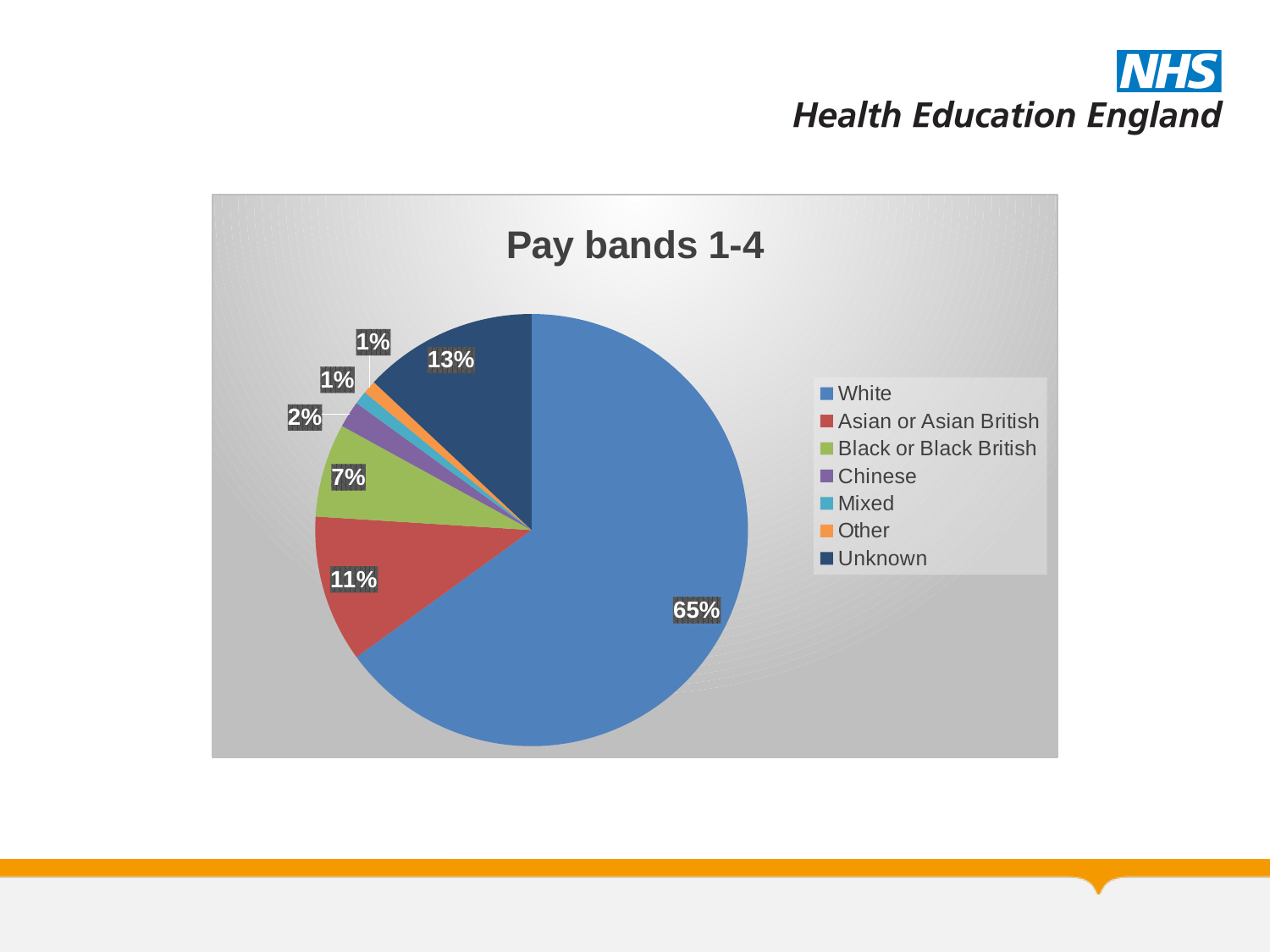
What percentage is shown for Asian or Asian British? 11% What is the title of the chart? Pay bands 1-4 What is the difference between the Unknown share and the Asian or Asian British share? 2% Which category has the largest slice of the pie? White What type of chart is shown on the slide? pie chart What percentage is shown for Unknown? 13% How many categories does the legend list? 7 Which is larger, the share for Black or Black British or the share for Unknown? Unknown What percentage is shown for Chinese? 2% What colour is the slice for Unknown? dark blue What percentage is shown for Black or Black British? 7% What share of the pie is labelled for White? 65%